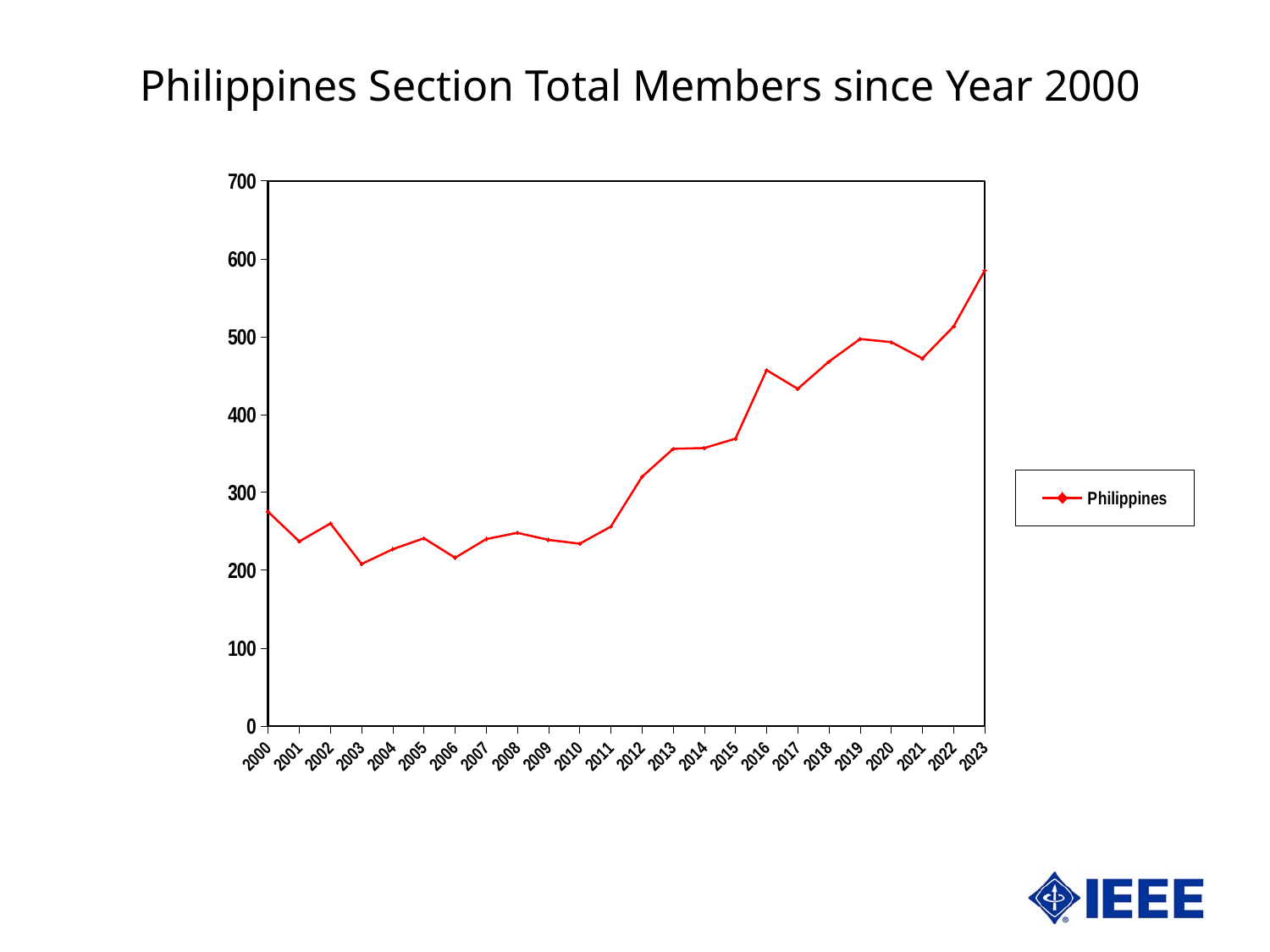
Is the value for 2016 greater or less than 400? greater How many years are plotted along the x axis? 24 How many series does the legend list? 1 Which year has more members, 2016 or 2017? 2016 Is the value for 2023 greater or less than 500? greater What is the title of the chart? Philippines Section Total Members since Year 2000 Is the value for 2013 greater or less than 400? less What kind of chart is shown on the slide? line chart Overall, do the values rise or fall from 2011 to 2023? rise Which year has the highest number of members? 2023 What is the name of the series shown in the legend? Philippines